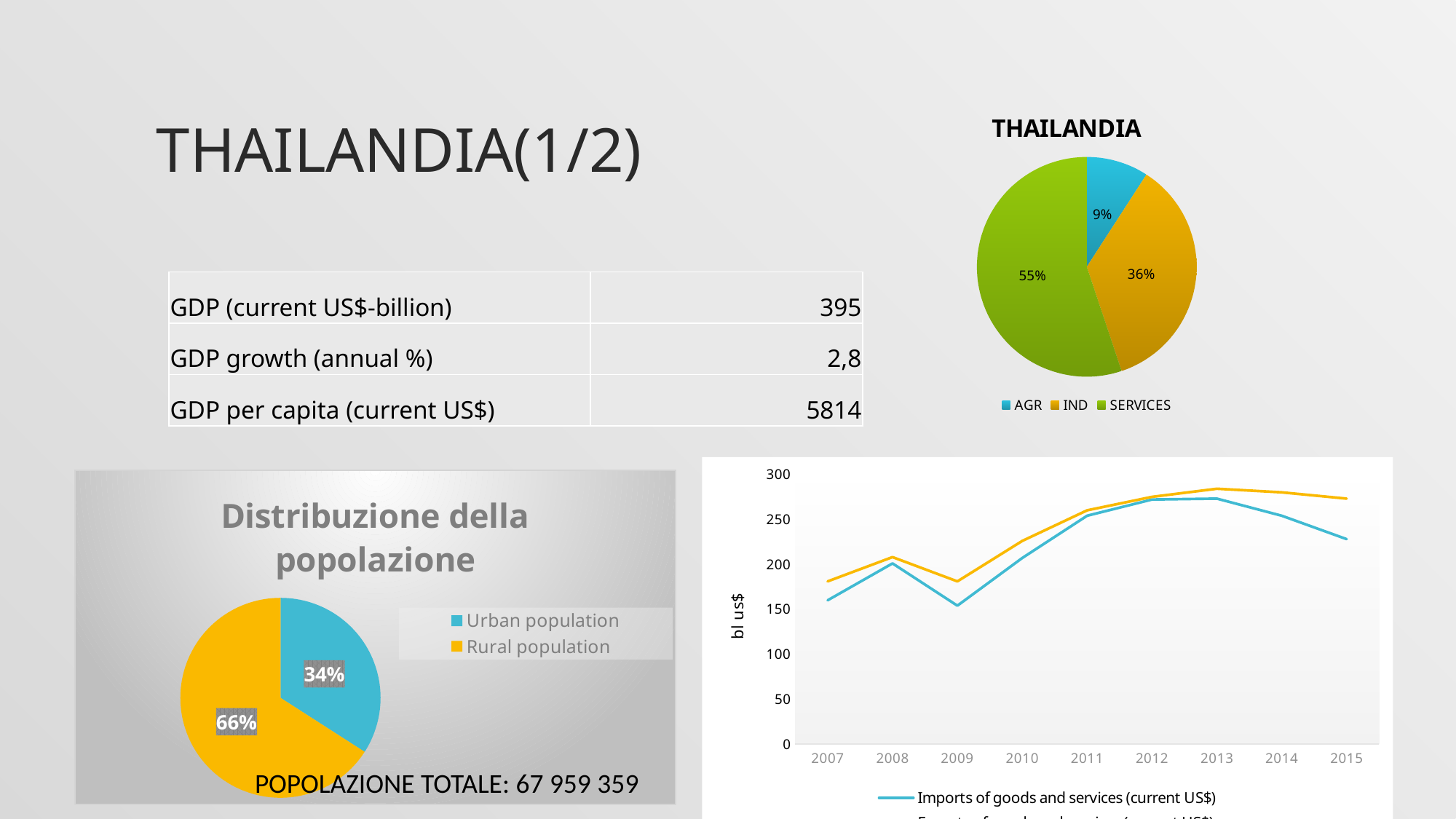
In the Distribuzione della popolazione chart, which is larger, Urban population or Rural population? Rural population In the Distribuzione della popolazione chart, what share is Rural population? 66% In the THAILANDIA pie chart, what is the difference between the SERVICES share and the IND share? 19% What kind of chart is the chart at the bottom right of the slide? Line chart In the THAILANDIA pie chart, what share does SERVICES have? 55% How many slices does the THAILANDIA pie chart have? 3 In the line chart at the bottom right, is the value of Imports of goods and services in 2009 greater or less than 200? less In the line chart at the bottom right, how many years are shown on the x axis? 9 In the THAILANDIA pie chart, which sector has the smallest share? AGR What kind of chart is the Distribuzione della popolazione chart? Pie chart In the THAILANDIA pie chart, what share does IND have? 36% In the line chart at the bottom right, does the Imports of goods and services line rise or fall from 2013 to 2015? Fall